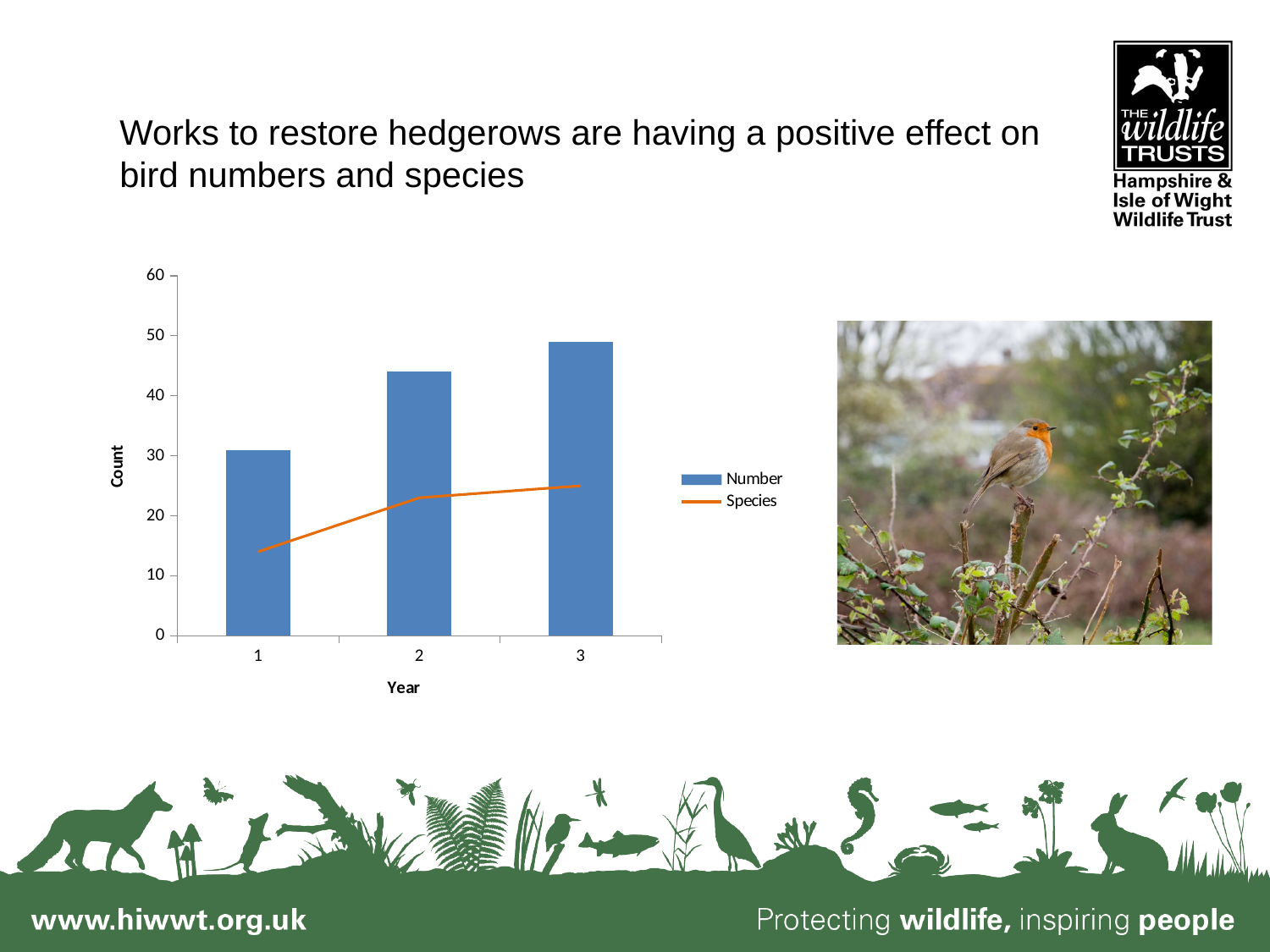
Is the value for Species in year 1 greater or less than 20? less Which year has the highest value for Number? 3 Is the value for Species in year 3 greater or less than 20? greater Do the values for Species rise or fall from year 1 to year 3? rise What are the two series named in the chart legend? Number and Species How many series does the chart legend list? 2 Is the value for Number in year 2 greater or less than 50? less What kind of chart is shown on the slide? A combined bar and line chart Which year has the lowest value for Number? 1 How many years are shown on the x axis of the chart? 3 Which is larger in year 2, the value for Number or the value for Species? Number